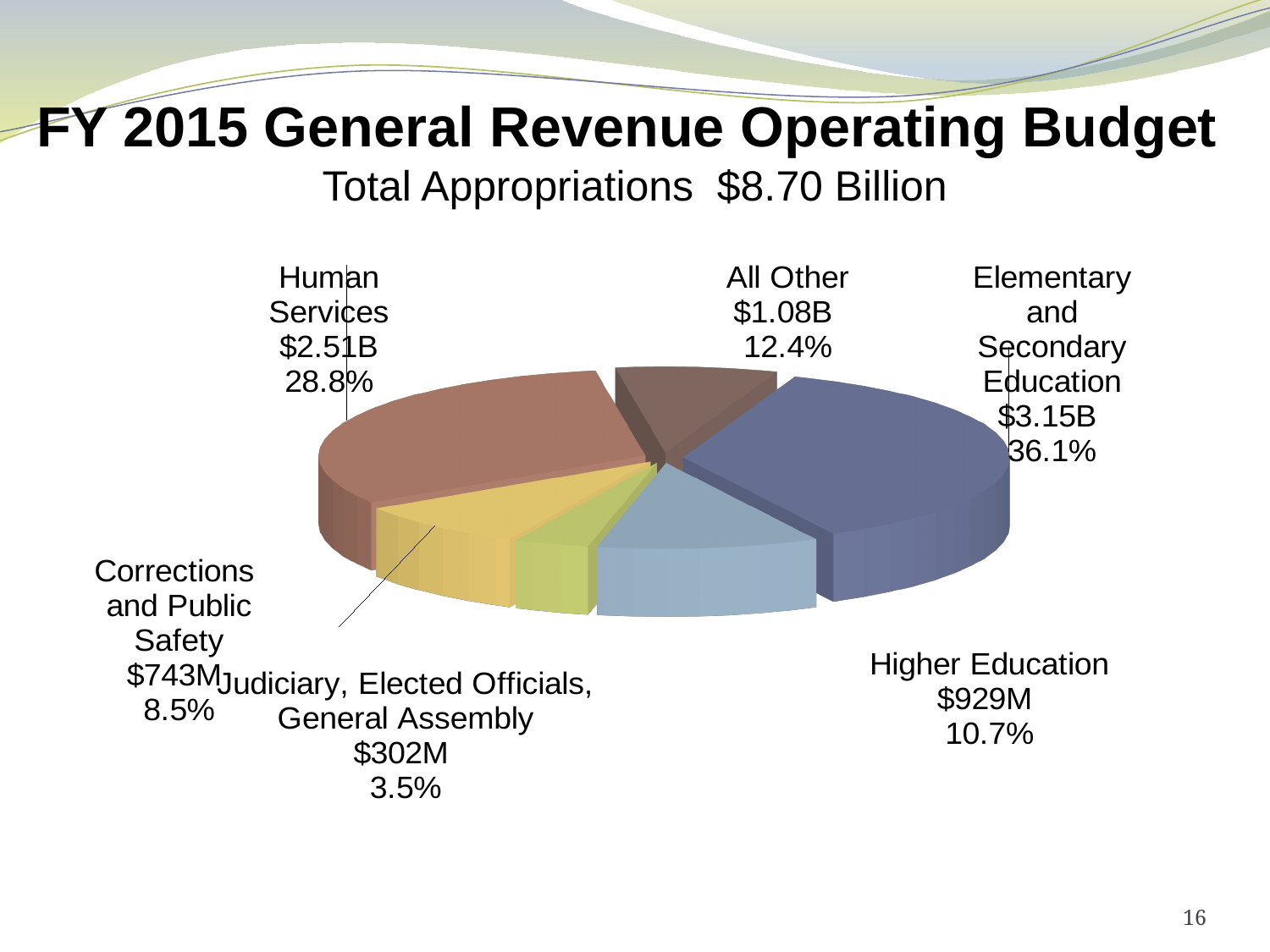
What is the dollar amount for Elementary and Secondary Education? $3.15B What total appropriations amount is stated in the chart subtitle? $8.70 Billion Which category has the largest share of the pie? Elementary and Secondary Education What percentage share does Human Services have? 28.8% What is the difference in percentage points between Elementary and Secondary Education and Human Services? 7.3 What percentage share does Corrections and Public Safety have? 8.5% What is the dollar amount for Judiciary, Elected Officials, General Assembly? $302M What is the dollar amount for Higher Education? $929M What kind of chart is shown on the slide? Pie chart Which category has the smallest share of the pie? Judiciary, Elected Officials, General Assembly How many slices does the pie chart have? 6 Which is larger, the share for All Other or the share for Higher Education? All Other